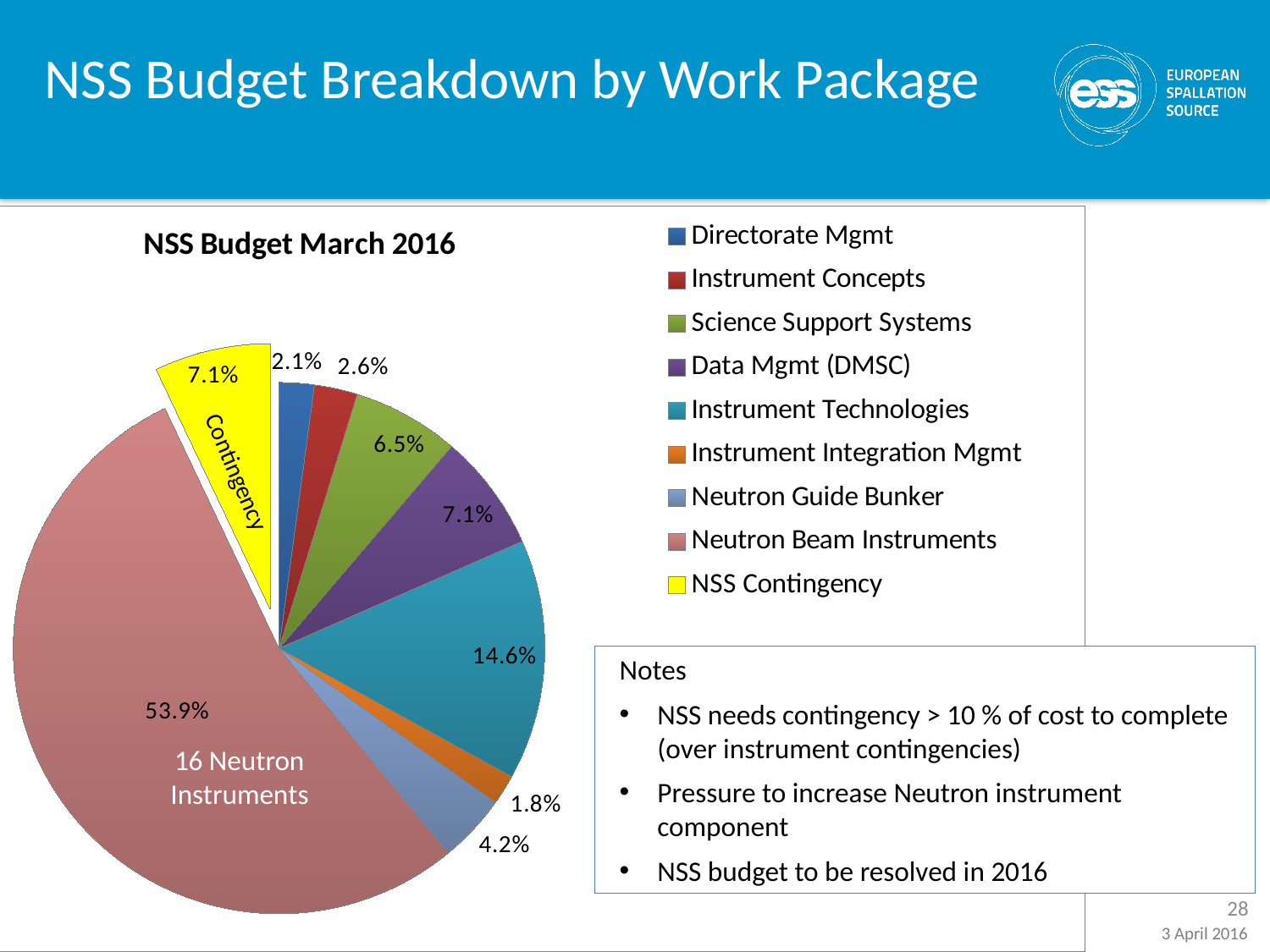
What is the title of the chart? NSS Budget March 2016 How many categories does the legend list? 9 What share of the NSS budget goes to Neutron Beam Instruments? 53.9% Which category has the smallest share of the NSS budget? Instrument Integration Mgmt What kind of chart is shown on the slide? pie chart What is the difference in share between Neutron Beam Instruments and Instrument Technologies? 39.3% What share of the NSS budget goes to Neutron Guide Bunker? 4.2% Which has a larger share of the NSS budget, Instrument Technologies or Data Mgmt (DMSC)? Instrument Technologies What share of the NSS budget is NSS Contingency? 7.1% Which category has the largest share of the NSS budget? Neutron Beam Instruments